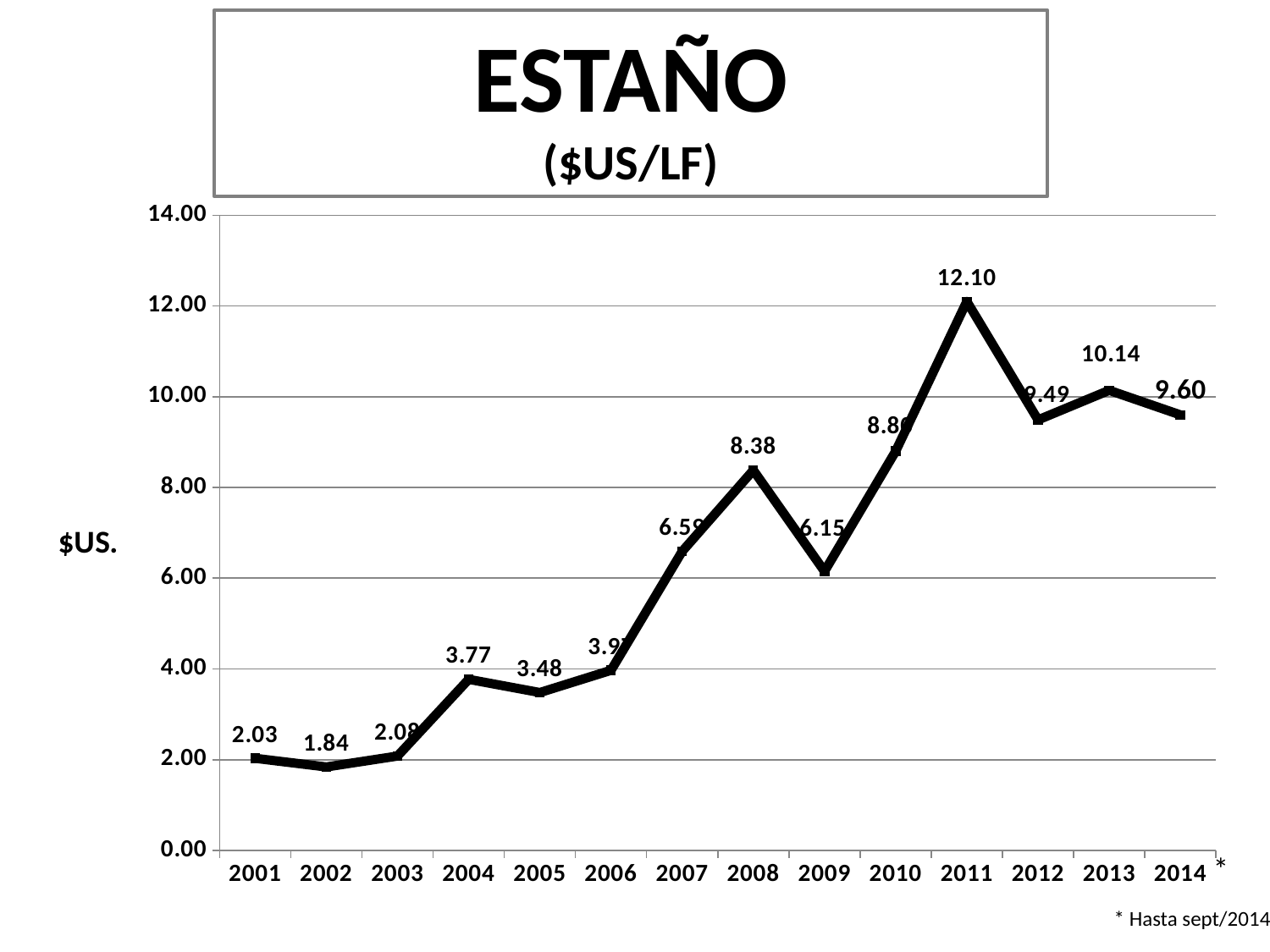
Which year has the lowest value? 2002 Which year has the highest value? 2011 Which year has the larger value, 2008 or 2009? 2008 What is the value for 2008? 8.38 What unit is given in the chart title below ESTAÑO? $US/LF What is the value for 2011? 12.10 What is the value for 2013? 10.14 What is the value for 2002? 1.84 What is the difference between the values for 2013 and 2014? 0.54 What kind of chart is shown? line chart Is the value for 2010 greater or less than 8.00? greater How many years are plotted on the chart? 14